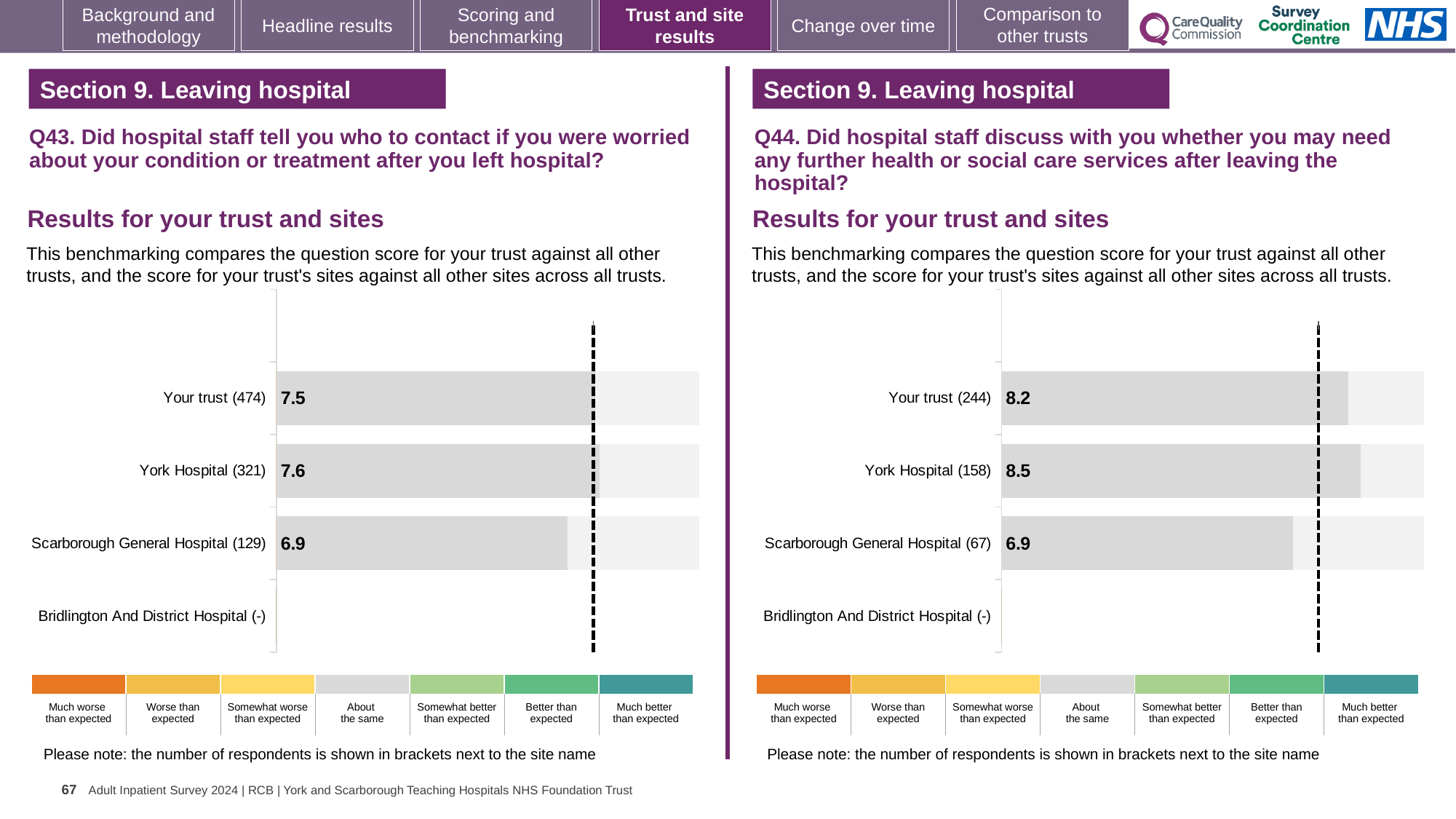
In the Q43 chart on the left, what is the difference between the York Hospital score and the Your trust score? 0.1 In the Q44 chart on the right, what is the difference between the York Hospital score and the Scarborough General Hospital score? 1.6 In the Q43 chart on the left, what is the score for Your trust? 7.5 In the Q43 chart on the left, which site has the lowest score? Scarborough General Hospital What type of chart is used in the Q43 chart on the left? Bar chart How many site rows (including Your trust) are listed in the Q44 chart on the right? 4 In the Q44 chart on the right, what is the score for Your trust? 8.2 In the Q44 chart on the right, what is the score for York Hospital? 8.5 In the Q44 chart on the right, which is larger: the score for Your trust or the score for Scarborough General Hospital? Your trust In the Q43 chart on the left, what is the score for Scarborough General Hospital? 6.9 In the Q44 chart on the right, which site has the highest score? York Hospital How many respondents are shown in brackets for Your trust in the Q43 chart on the left? 474